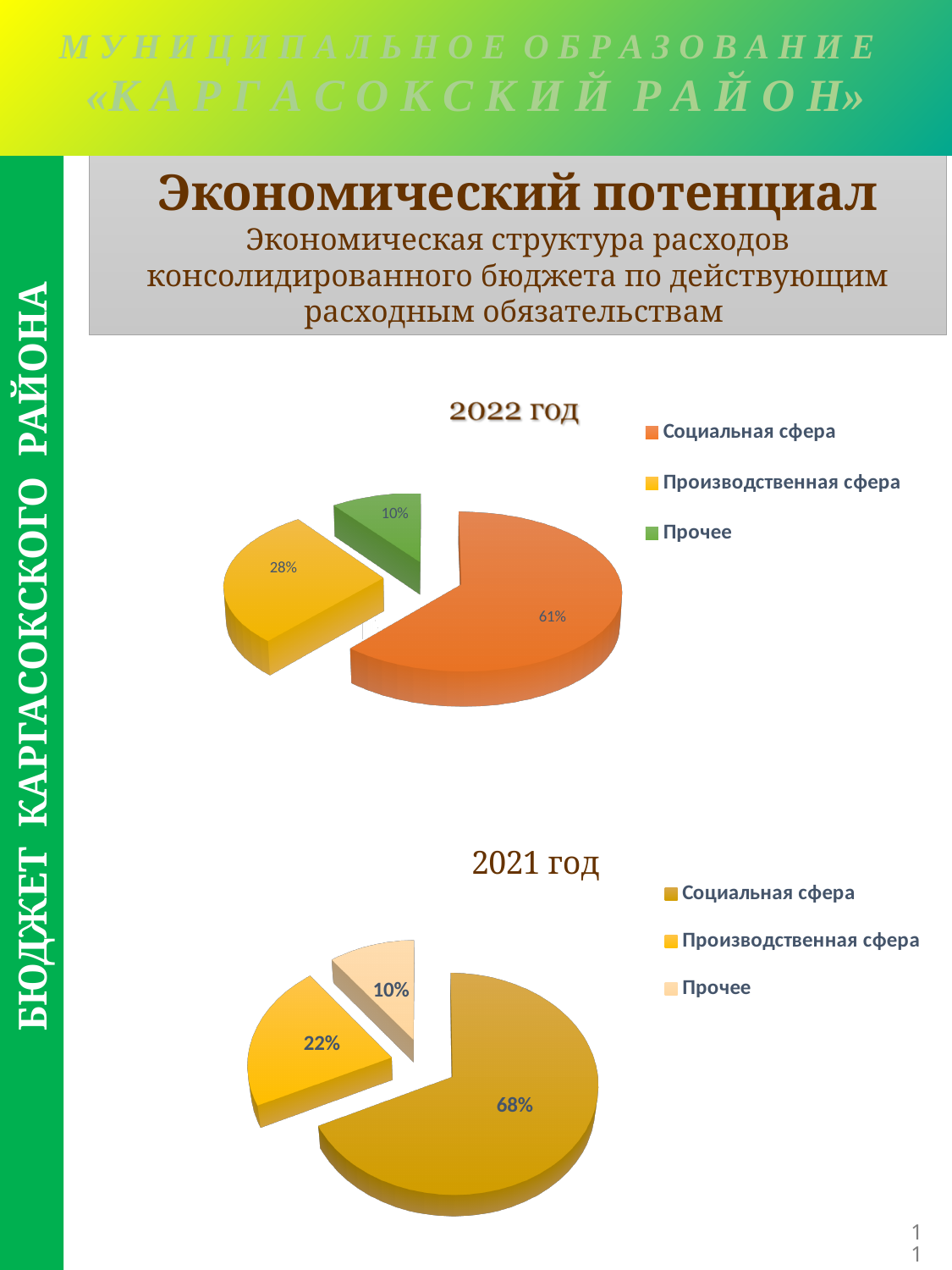
In the "2021 год" chart, what is the difference between the shares of Социальная сфера and Производственная сфера? 46% In the "2022 год" chart, what share does Социальная сфера have? 61% In the "2022 год" chart, which category has the smallest slice? Прочее In the "2022 год" chart, what share does Прочее have? 10% In the "2021 год" chart, which category has the largest slice? Социальная сфера Which is larger: the share of Производственная сфера in the "2022 год" chart or in the "2021 год" chart? 2022 год How many categories does the "2022 год" chart show? 3 In the "2021 год" chart, what share does Производственная сфера have? 22% What type of chart is the "2021 год" chart? Pie chart In the "2022 год" chart, what share does Производственная сфера have? 28% In the "2022 год" chart, what colour is the Прочее slice? Green In the "2021 год" chart, what share does Социальная сфера have? 68%